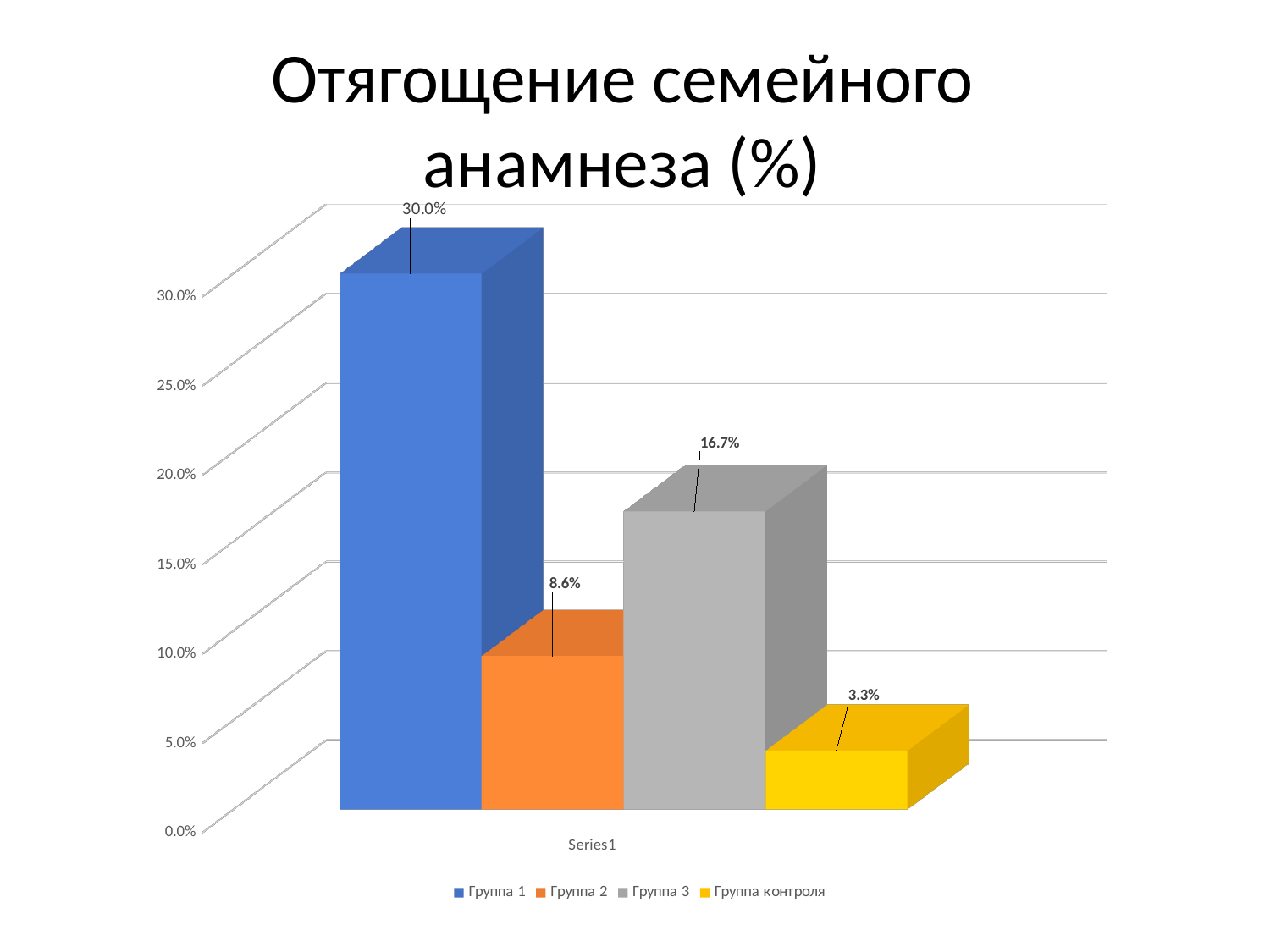
What kind of chart is shown on the slide? Bar chart How many series does the legend list? 4 Which group has the highest value? Группа 1 Which is larger, the value for Группа 2 or the value for Группа 3? Группа 3 What is the value for Группа 3? 16.7% What is the value for Группа 1? 30.0% What is the difference between the values for Группа 1 and Группа 3? 13.3% What is the title of the chart? Отягощение семейного анамнеза (%) Which group has the lowest value? Группа контроля What is the value for Группа 2? 8.6% What is the value for Группа контроля? 3.3% What is the difference between the values for Группа 2 and Группа контроля? 5.3%